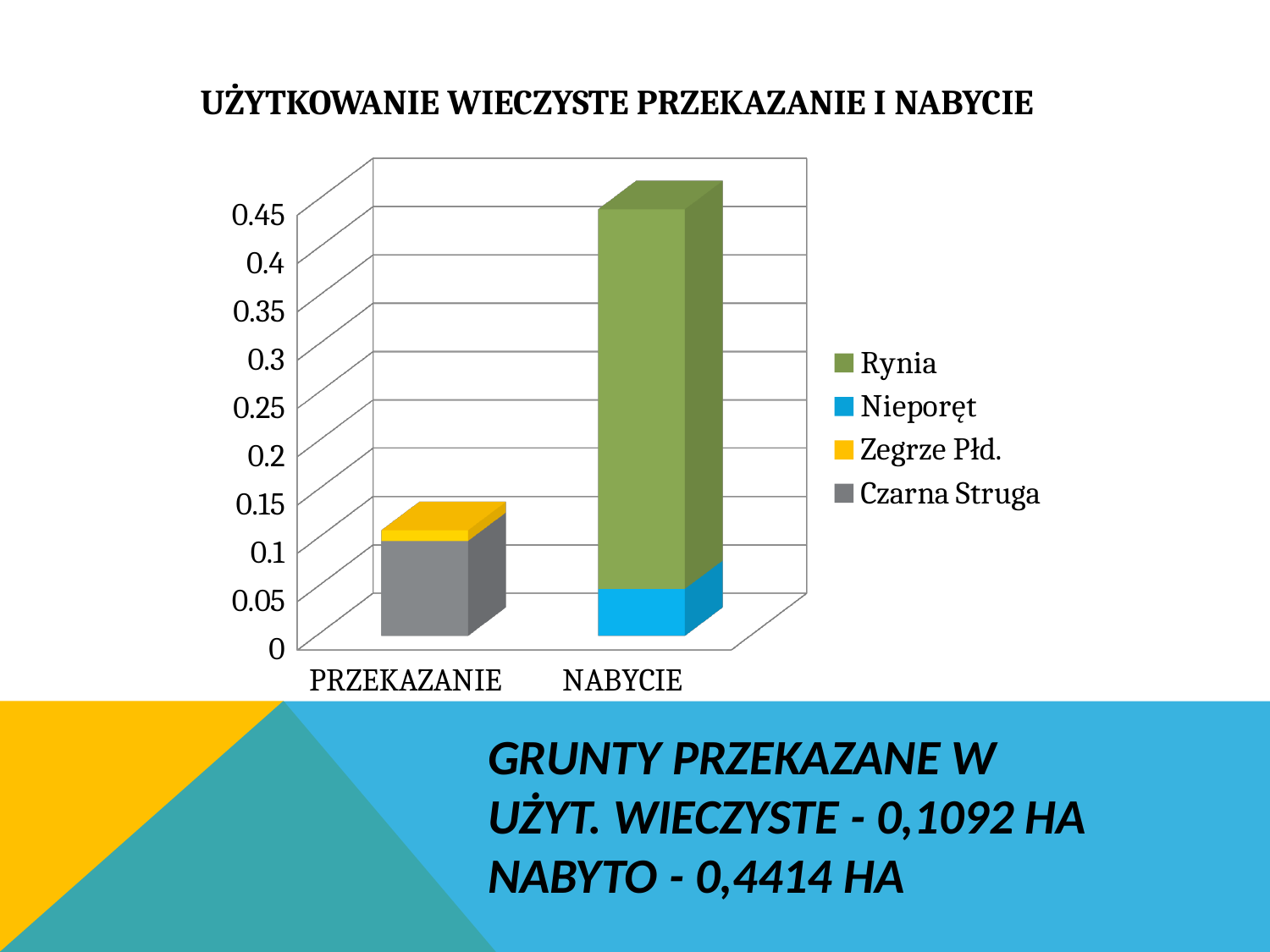
Which category has the taller stacked bar, PRZEKAZANIE or NABYCIE? NABYCIE Is the total value of the NABYCIE bar greater or less than 0.4? greater Which two series make up the PRZEKAZANIE bar? Czarna Struga and Zegrze Płd. Which category has the highest total value in the chart? NABYCIE Is the Rynia segment of the NABYCIE bar greater or less than 0.3? greater What kind of chart is shown on the slide? bar chart Is the total value of the PRZEKAZANIE bar greater or less than 0.15? less Which category has the lowest total value in the chart? PRZEKAZANIE Which series forms the largest segment of the NABYCIE bar? Rynia How many series does the chart legend list? 4 How many categories are shown on the x axis of the chart? 2 What is the title of the chart? UŻYTKOWANIE WIECZYSTE PRZEKAZANIE I NABYCIE